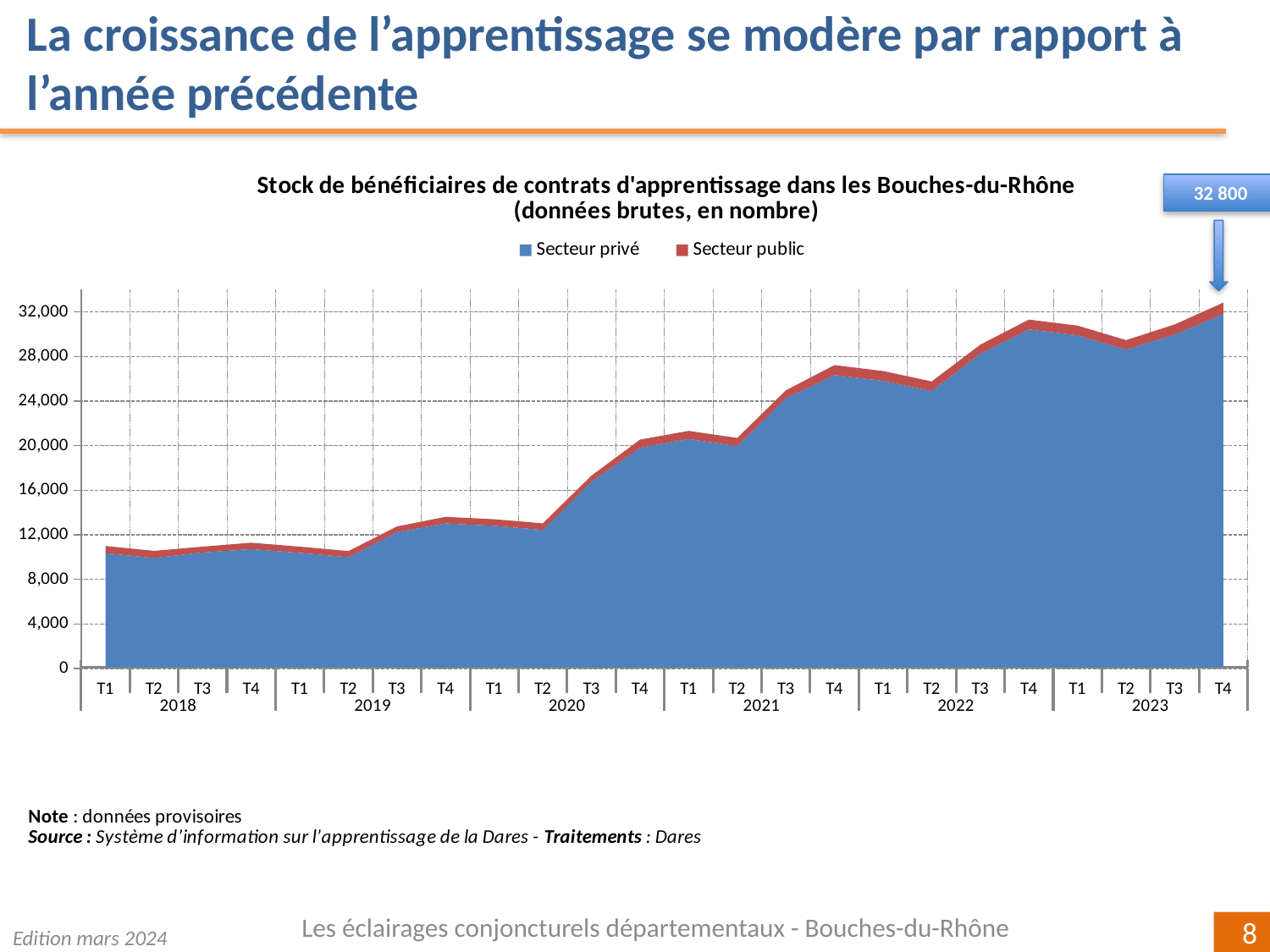
Is the total value for T1 2018 greater or less than 12,000? less Which is larger, the total for T4 2021 or the total for T4 2020? T4 2021 Which two series are listed in the legend? Secteur privé and Secteur public Is the total value for T4 2020 greater or less than 16,000? greater Overall, do the values rise or fall from T1 2018 to T4 2023? rise How many series does the legend list? 2 Is the total value for T1 2018 greater or less than 8,000? greater How many quarterly points are plotted along the x axis? 24 What kind of chart is shown on the slide? Stacked area chart What is the total stock of apprenticeship beneficiaries indicated for T4 2023? 32 800 Which quarter has the highest total stock of beneficiaries? T4 2023